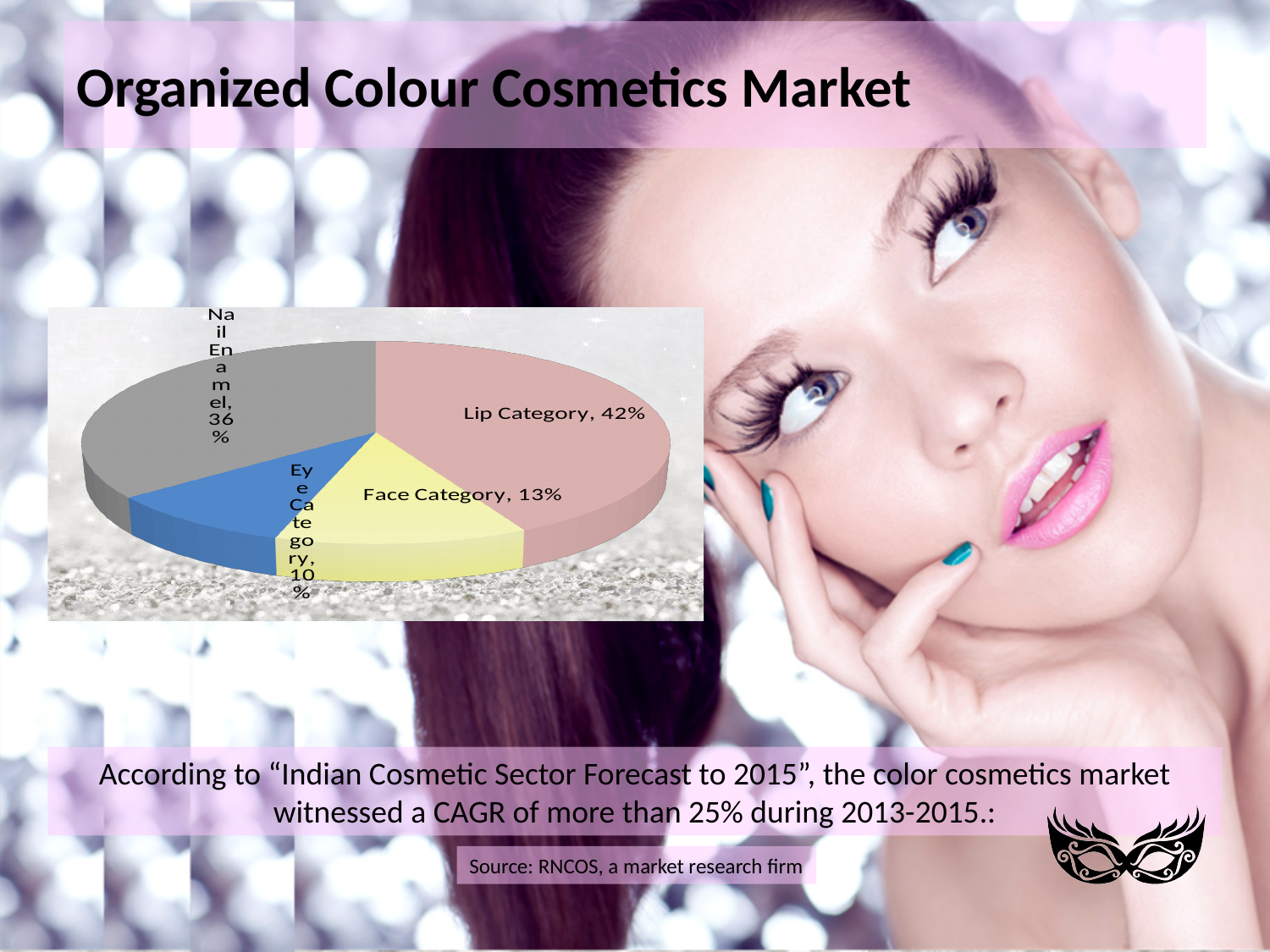
What share of the pie does Eye Category hold? 10% Which category has the largest slice of the pie? Lip Category Which is larger, the Nail Enamel slice or the Face Category slice? Nail Enamel What is the difference in percentage points between Lip Category and Nail Enamel? 6 percentage points What type of chart is shown on the slide? Pie chart How many slices does the pie chart have? 4 Which category has the smallest slice of the pie? Eye Category What share of the pie does Nail Enamel hold? 36% What share of the pie does Lip Category hold? 42% What colour is the Lip Category slice? Pink What is the difference in percentage points between Face Category and Eye Category? 3 percentage points What share of the pie does Face Category hold? 13%